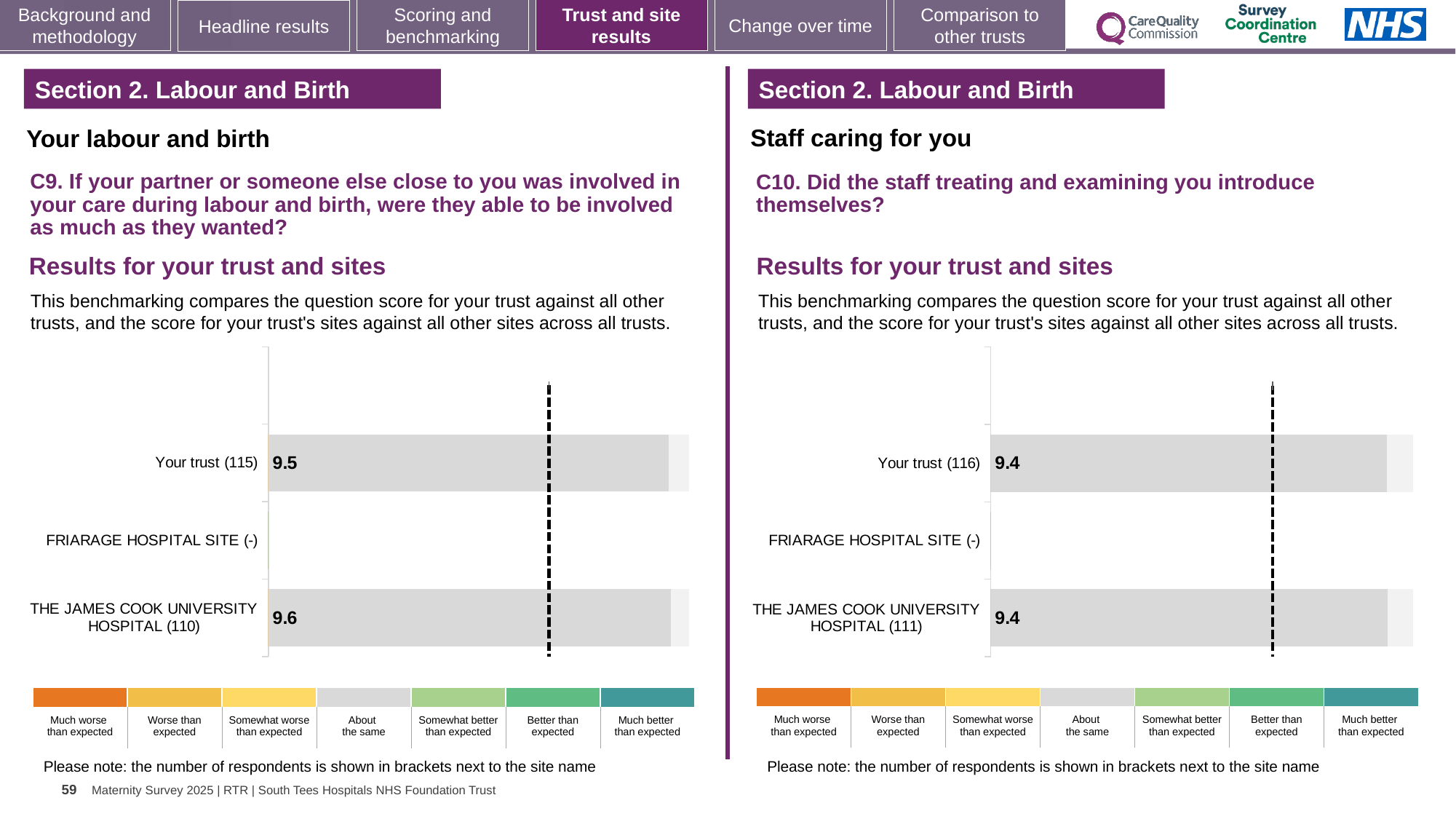
On the C9 chart (left), what is the score for Your trust? 9.5 What type of chart is used on the C10 chart (right)? Bar chart On the C9 chart (left), what is the score for The James Cook University Hospital? 9.6 On the C10 chart (right), how many respondents are shown in brackets for The James Cook University Hospital? 111 How many site/trust categories are listed on the C9 chart (left)? 3 How many categories does the colour legend below each chart list? 7 On the C9 chart (left), what is the difference between the score for The James Cook University Hospital and the score for Your trust? 0.1 On the C10 chart (right), what is the score for The James Cook University Hospital? 9.4 On the C10 chart (right), what is the difference between the score for Your trust and the score for The James Cook University Hospital? 0 On the C9 chart (left), how many respondents are shown in brackets for Your trust? 115 On the C10 chart (right), what is the score for Your trust? 9.4 On the C9 chart (left), which has the higher score: Your trust or The James Cook University Hospital? The James Cook University Hospital